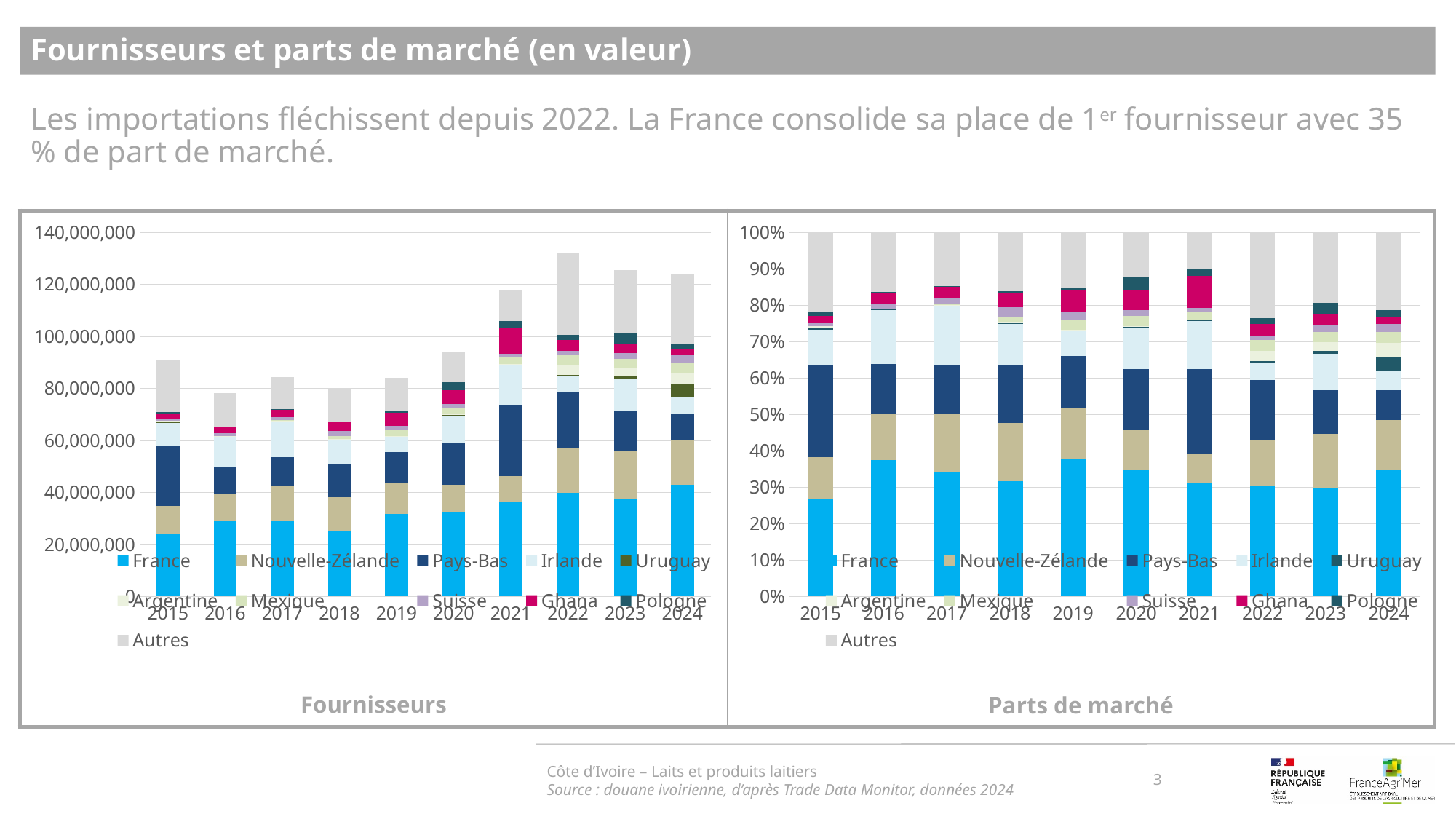
What is the title of the chart on the right of the slide? Parts de marché In the "Parts de marché" chart, is the France share in 2016 greater or less than 30%? greater In the "Parts de marché" chart, is the France share in 2015 greater or less than 30%? less In the "Fournisseurs" chart, which year has the tallest total bar? 2022 How many years are shown on the x axis of the "Parts de marché" chart? 10 In the "Fournisseurs" chart, is the total bar for 2015 greater or less than 100,000,000? less What kind of chart is the "Fournisseurs" chart on the left? Stacked bar chart How many series does the legend of the "Fournisseurs" chart list? 11 In the "Fournisseurs" chart, do the total bars rise or fall from 2022 to 2024? fall In the "Fournisseurs" chart, which is larger: the France segment in 2024 or the France segment in 2015? 2024